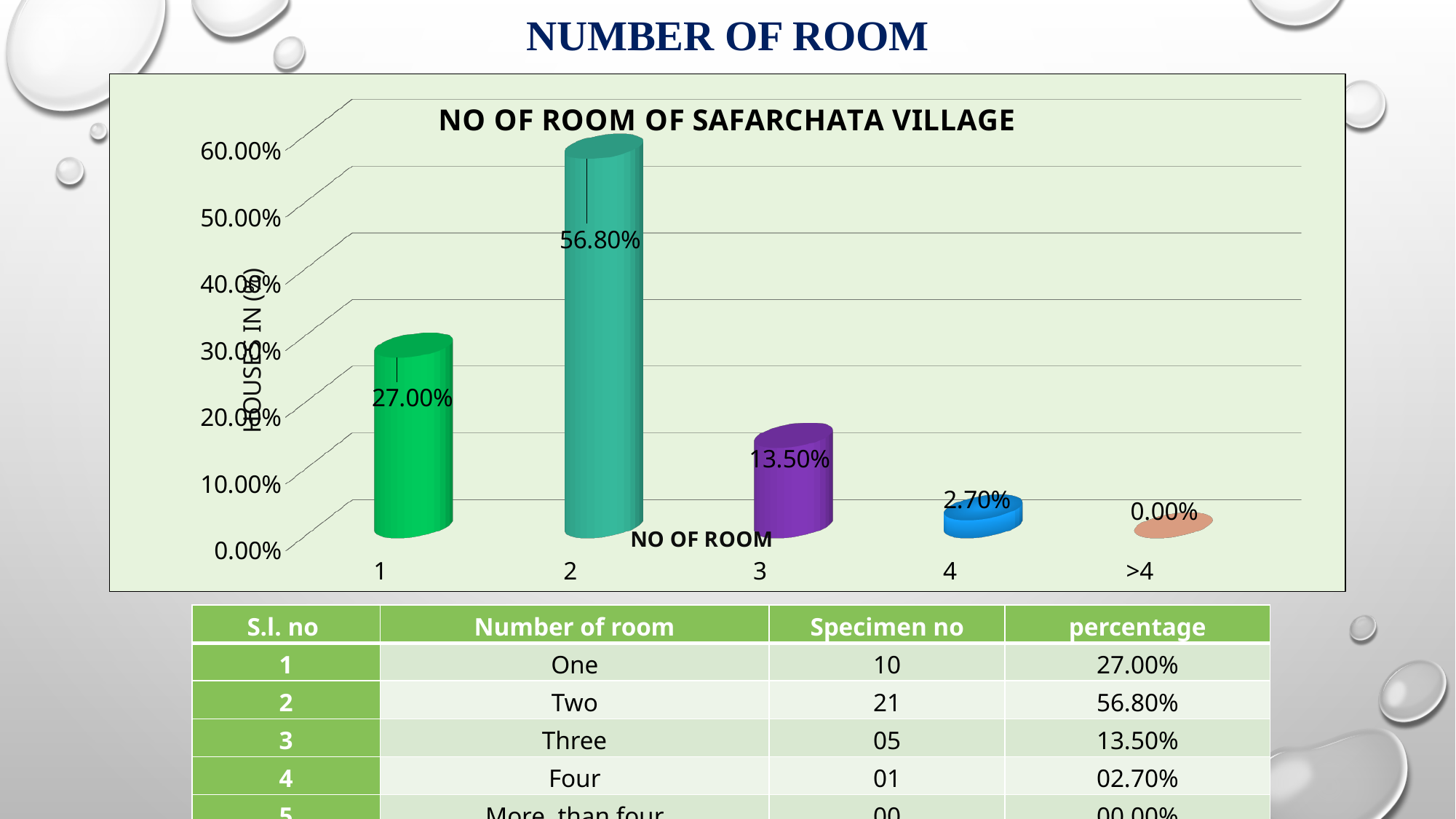
What is the value for category 2 in the chart? 56.80% What is the value for category 1 in the chart? 27.00% How many categories are shown on the x axis of the chart? 5 What is the value for category 3 in the chart? 13.50% What kind of chart is shown on the slide? bar chart What is the value for category 4 in the chart? 2.70% What is the value for category >4 in the chart? 0.00% Which category has the lowest value in the chart? >4 Which category has the highest value in the chart? 2 What is the difference between the values for category 2 and category 1? 29.80% Which is larger, the value for category 3 or the value for category 4? 3 What is the title of the chart? NO OF ROOM OF SAFARCHATA VILLAGE